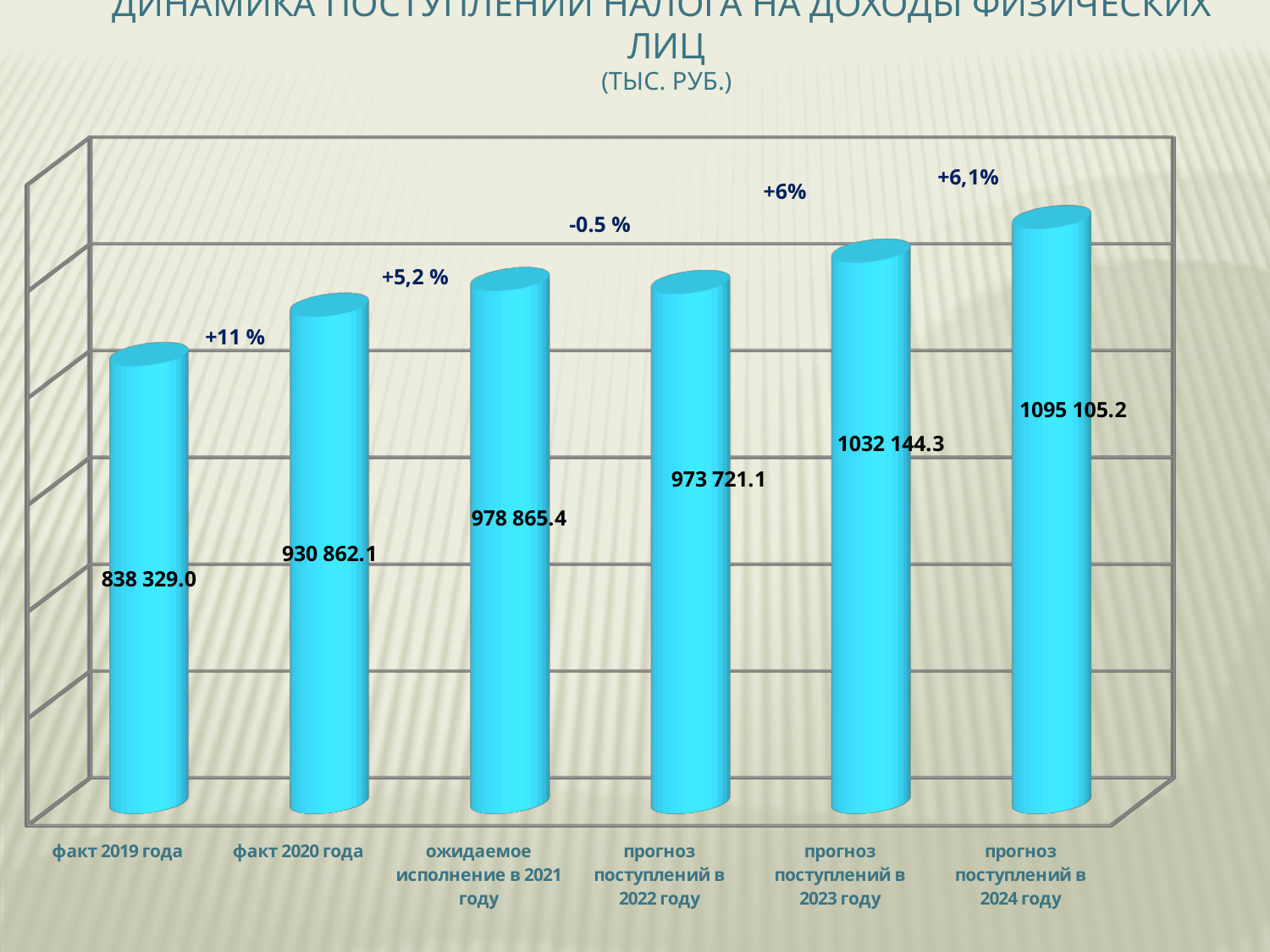
What is the difference between the values for факт 2020 года and факт 2019 года? 92 533.1 What is the value for факт 2019 года? 838 329.0 Which is larger: the value for ожидаемое исполнение в 2021 году or the value for прогноз поступлений в 2022 году? ожидаемое исполнение в 2021 году Which category has the highest value? прогноз поступлений в 2024 году What is the difference between the values for прогноз поступлений в 2024 году and прогноз поступлений в 2023 году? 62 960.9 How many categories are shown on the chart? 6 What unit is given in the chart title? ТЫС. РУБ. What percentage change is annotated above the bar for прогноз поступлений в 2022 году? -0.5 % What kind of chart is shown on the slide? bar chart What is the value for прогноз поступлений в 2023 году? 1032 144.3 Which category has the lowest value? факт 2019 года What is the value for ожидаемое исполнение в 2021 году? 978 865.4